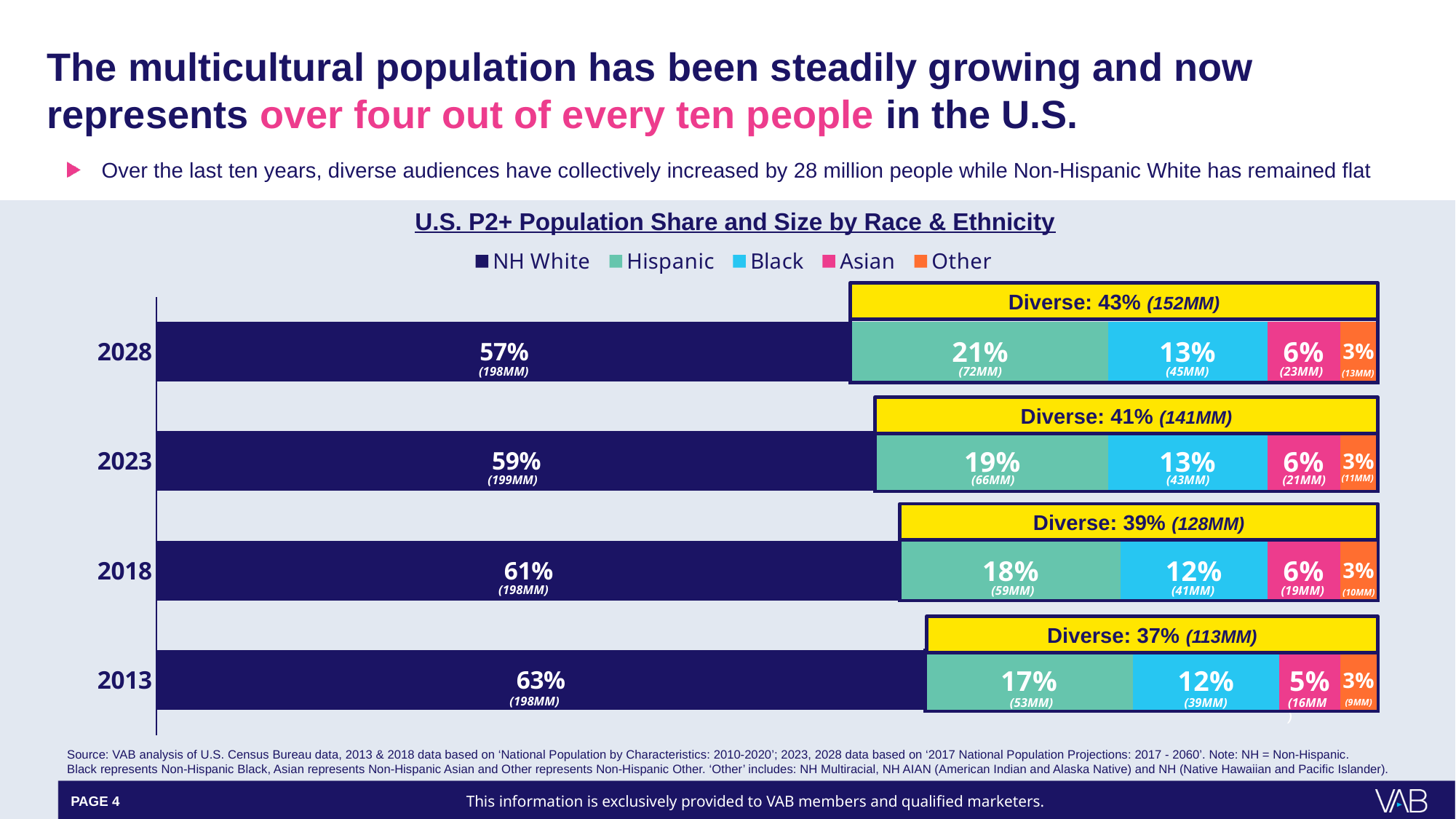
Is the Black share larger in 2028 or in 2013? 2028 What is the Black population size in millions in 2023? 43MM Which year has the lowest Hispanic share? 2013 Which year has the highest NH White share? 2013 How many years are shown on the chart? 4 What is the Diverse share and size shown for 2018? 39% (128MM) What is the Asian share of the population in 2013? 5% What kind of chart is shown on the slide? Stacked bar chart What is the NH White share of the U.S. population in 2013? 63% How many series does the legend list? 5 What is the difference in percentage points between the Hispanic share in 2028 and in 2013? 4 What is the Hispanic share of the U.S. population in 2028? 21%